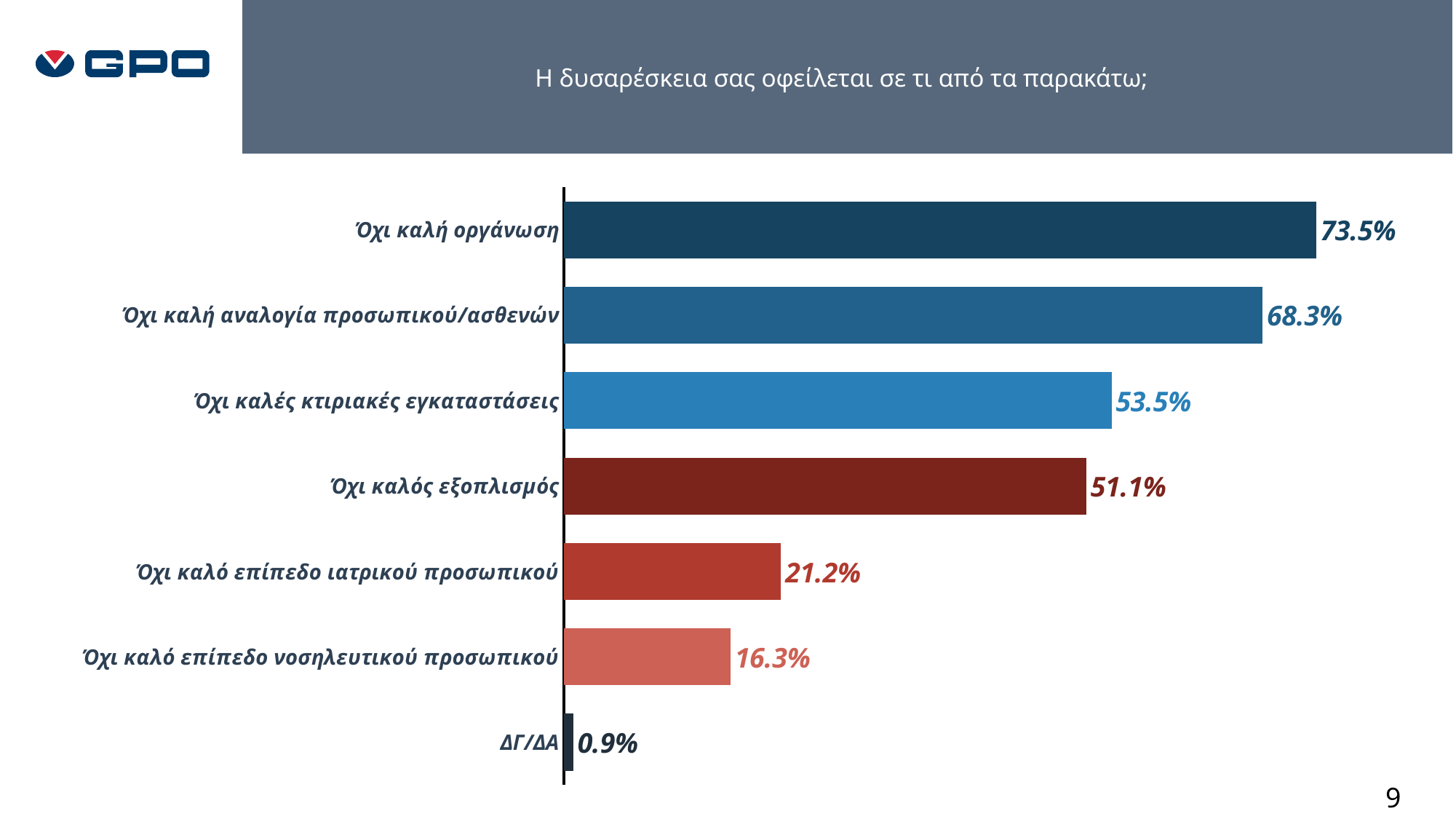
What is the value for 'Όχι καλή οργάνωση'? 73.5% Which category has the highest value? Όχι καλή οργάνωση What is the value for 'Όχι καλός εξοπλισμός'? 51.1% What is the value for 'Όχι καλό επίπεδο νοσηλευτικού προσωπικού'? 16.3% Which is larger: 'Όχι καλές κτιριακές εγκαταστάσεις' or 'Όχι καλός εξοπλισμός'? Όχι καλές κτιριακές εγκαταστάσεις What is the difference between 'Όχι καλή οργάνωση' and 'Όχι καλή αναλογία προσωπικού/ασθενών'? 5.2% Which category has the lowest value? ΔΓ/ΔΑ What is the title of the chart? Η δυσαρέσκεια σας οφείλεται σε τι από τα παρακάτω; What kind of chart is shown on the slide? Bar chart How many categories are shown in the chart? 7 What is the value for 'ΔΓ/ΔΑ'? 0.9% What is the difference between 'Όχι καλό επίπεδο ιατρικού προσωπικού' and 'Όχι καλό επίπεδο νοσηλευτικού προσωπικού'? 4.9%